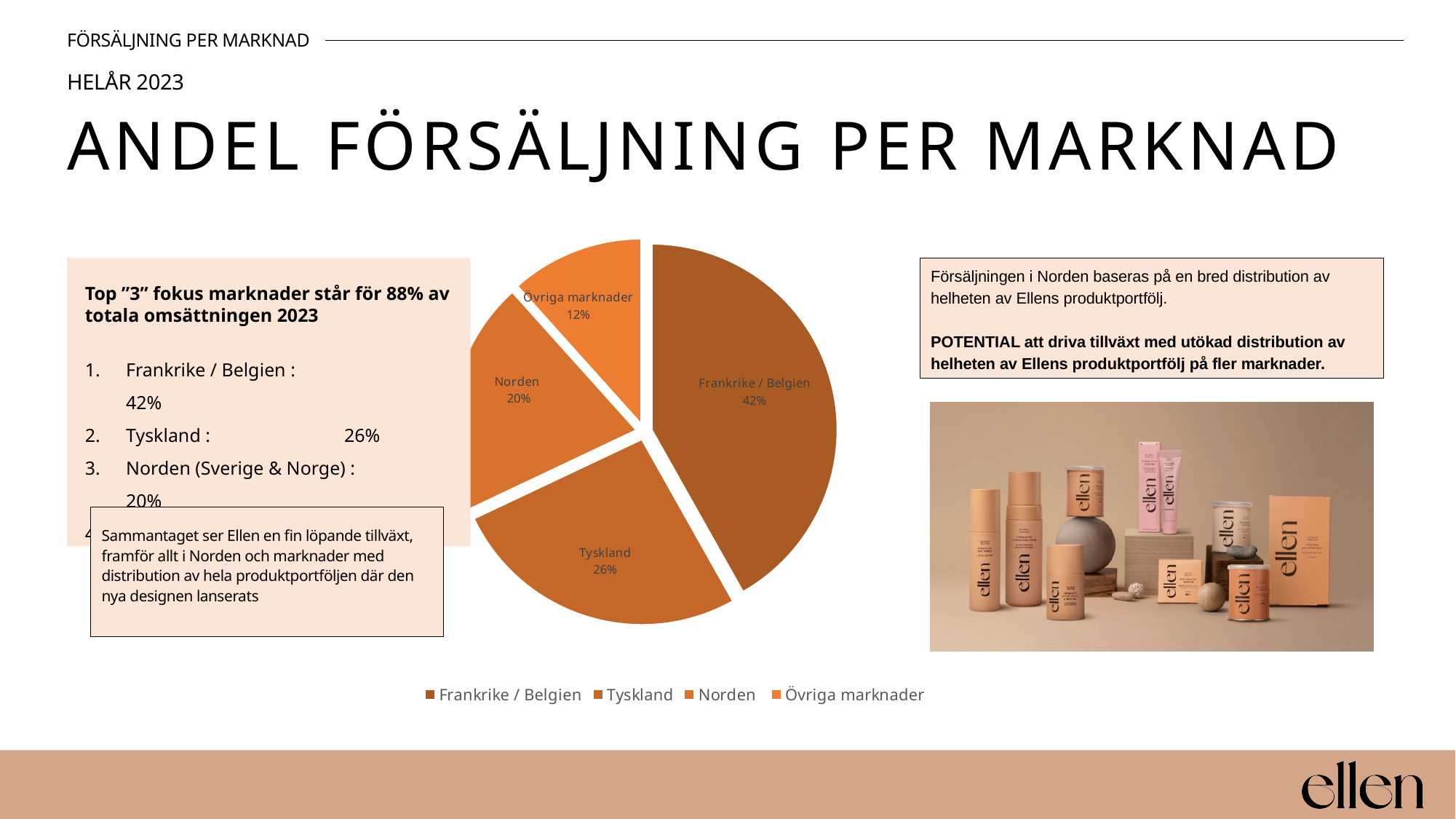
How many slices does the pie chart have? 4 How many entries does the legend list? 4 Which is larger, the share for Norden or the share for Övriga marknader? Norden Which market has the smallest slice in the pie chart? Övriga marknader What share of sales does Norden account for in the pie chart? 20% What is the difference in percentage points between Frankrike / Belgien and Tyskland? 16 What share of sales does Övriga marknader account for in the pie chart? 12% Which market has the largest slice in the pie chart? Frankrike / Belgien What is the combined share of Tyskland and Norden? 46% What share of sales does Frankrike / Belgien account for in the pie chart? 42% What kind of chart is shown on the slide? Pie chart What share of sales does Tyskland account for in the pie chart? 26%